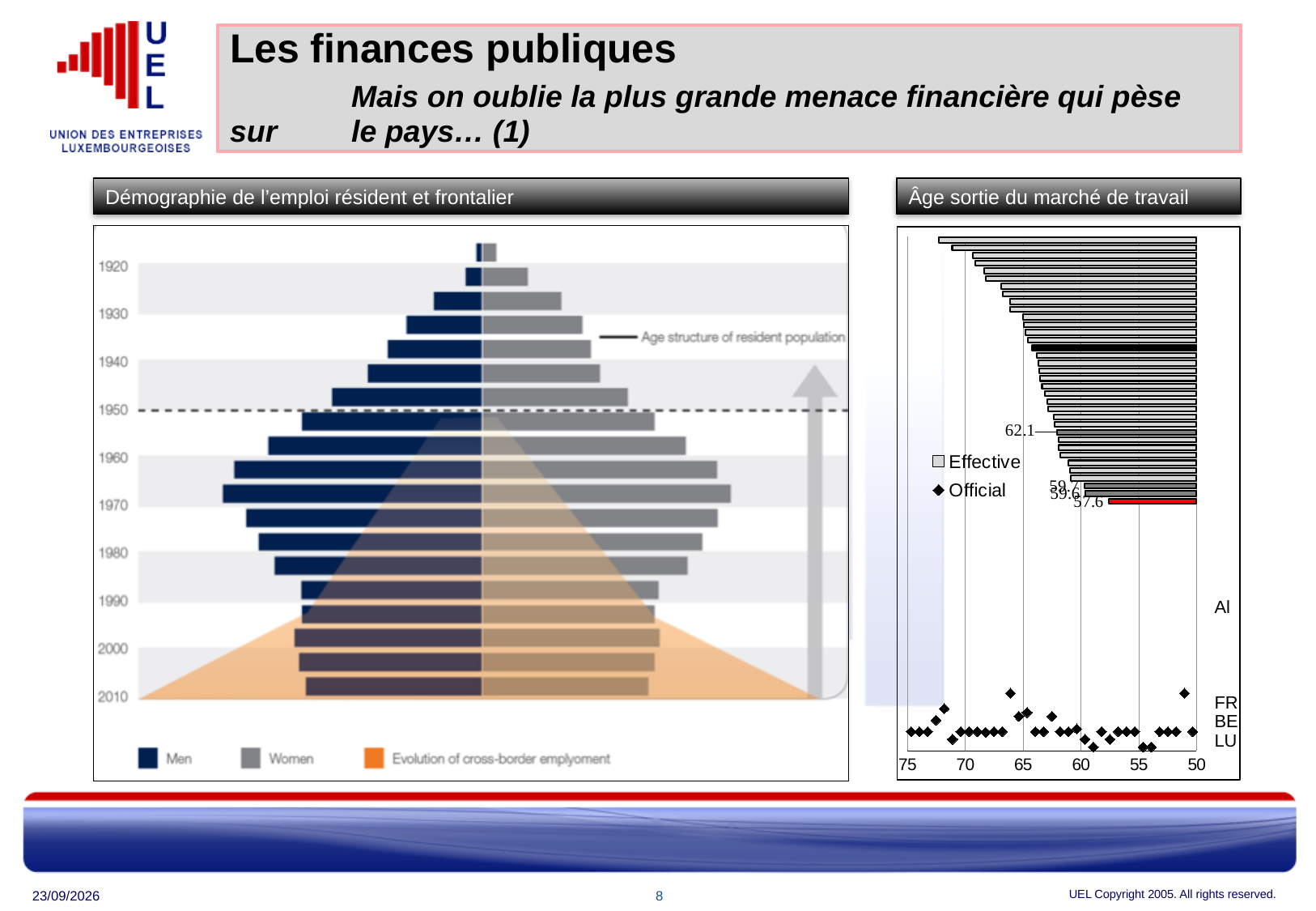
How many series does the legend of the chart 'Âge sortie du marché de travail' list? 2 In the chart 'Démographie de l'emploi résident et frontalier', at which year is the horizontal dashed line drawn? 1950 What kind of chart is the chart titled 'Âge sortie du marché de travail'? bar chart In the chart 'Âge sortie du marché de travail', is the value of the topmost bar greater or less than 70? greater What is the latest year labelled on the vertical axis of the chart 'Démographie de l'emploi résident et frontalier'? 2010 In the chart 'Âge sortie du marché de travail', which series is shown with diamond markers? Official How many entries does the legend of the chart 'Démographie de l'emploi résident et frontalier' list? 3 In the chart 'Démographie de l'emploi résident et frontalier', what does the orange area represent? Evolution of cross-border employment What is the highest tick value shown on the x axis of the chart 'Âge sortie du marché de travail'? 75 In the chart 'Âge sortie du marché de travail', do the bar lengths increase or decrease going from the top bar to the bottom bar? decrease In the chart 'Âge sortie du marché de travail', is the value of the red bar at the bottom of the bar group greater or less than 60? less What is the lowest tick value shown on the x axis of the chart 'Âge sortie du marché de travail'? 50